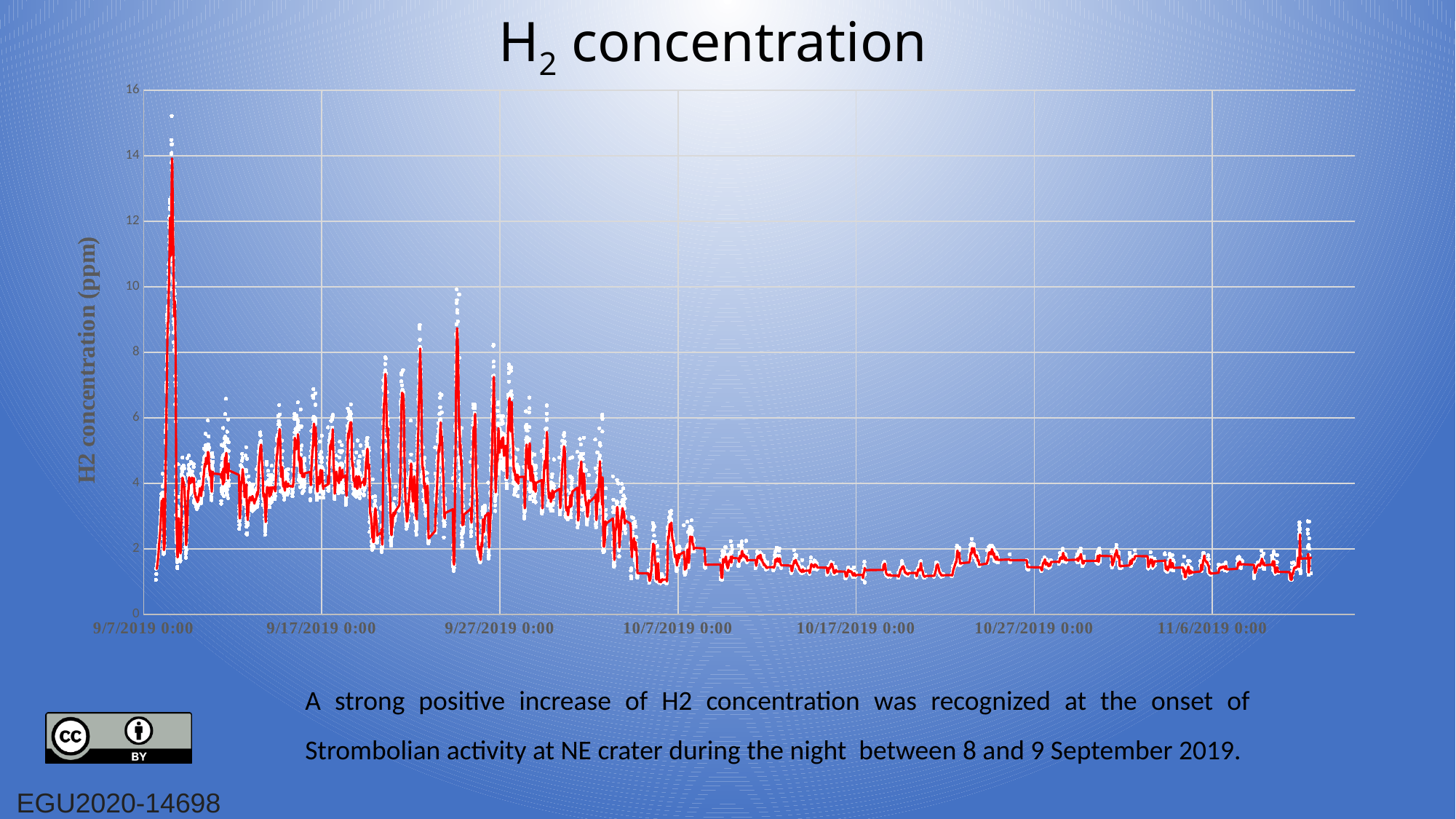
Which is larger: the H2 concentration around 9/17/2019 0:00 or around 10/27/2019 0:00? 9/17/2019 0:00 What is the title of the chart? H2 concentration What is the highest value shown on the vertical axis? 16 Around which date does the H2 concentration reach its maximum? shortly after 9/7/2019 0:00 Are the values of the red line around 10/17/2019 0:00 greater or less than 2 ppm? less Are the values of the red line around 11/6/2019 0:00 greater or less than 4 ppm? less What kind of chart is shown on the slide? line chart Is the highest peak of the red line, near 9/8/2019, greater or less than 12 ppm? greater What is the label of the vertical axis? H2 concentration (ppm) How many date labels are shown on the horizontal axis? 7 Overall, do the H2 concentration values rise or fall from 9/7/2019 to 11/6/2019? fall